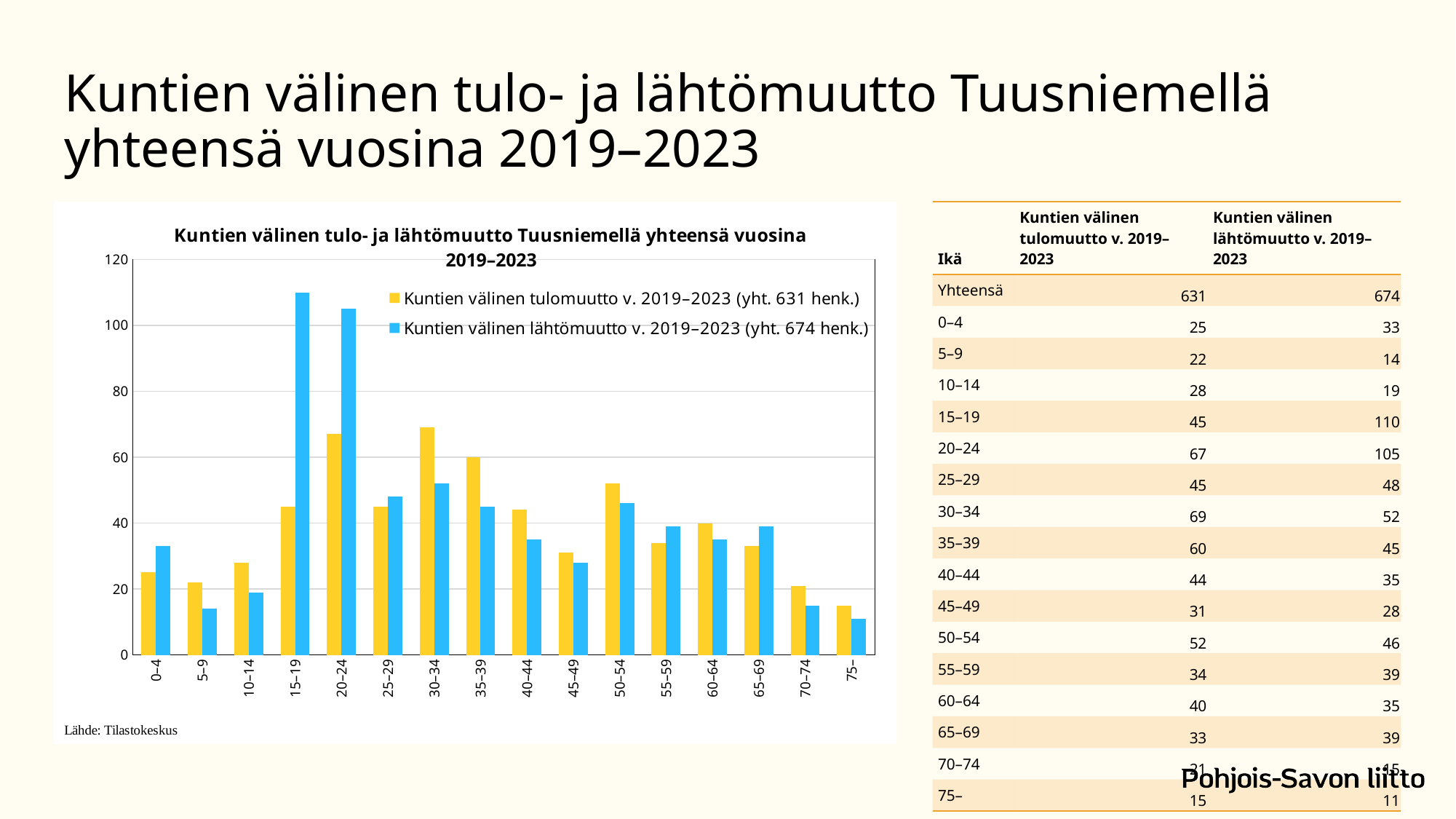
Is the value of Kuntien välinen lähtömuutto for the 20–24 age group greater or less than 100? greater For the 0–4 age group, which is larger: tulomuutto or lähtömuutto? lähtömuutto Which age group has the highest value for Kuntien välinen lähtömuutto? 15–19 What is the value of Kuntien välinen tulomuutto for the 35–39 age group? 60 What kind of chart is shown on the slide? bar chart How many series does the chart's legend list? 2 How many age groups are shown on the x axis of the chart? 16 What is the difference between lähtömuutto and tulomuutto for the 15–19 age group? 65 What is the value of Kuntien välinen lähtömuutto for the 15–19 age group? 110 Does Kuntien välinen tulomuutto rise or fall from the 30–34 age group to the 45–49 age group? fall According to the legend, what is the total number of people for Kuntien välinen lähtömuutto v. 2019–2023? 674 henk. Which age group has the lowest value for Kuntien välinen tulomuutto? 75–